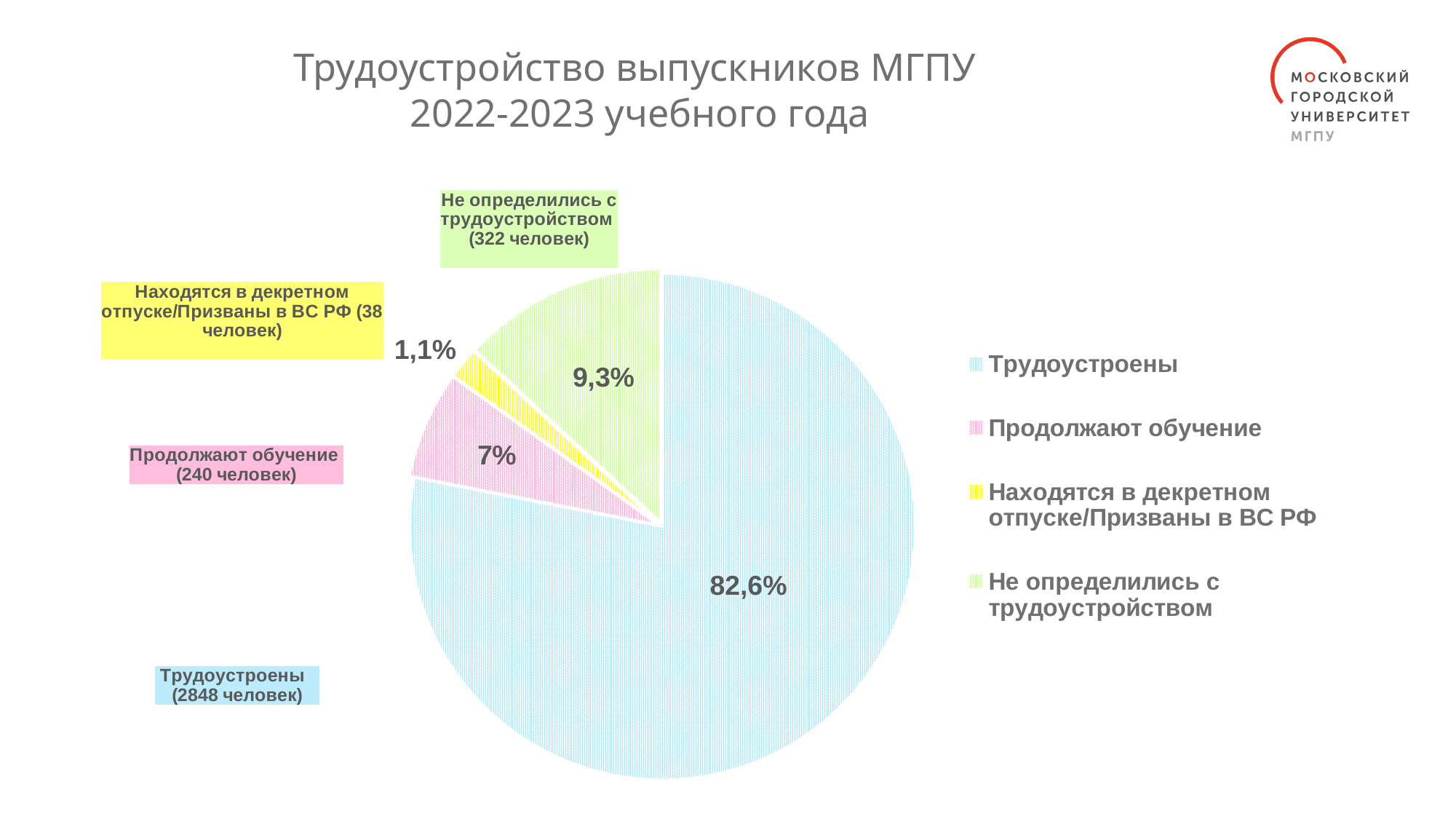
How many people are in the "Трудоустроены" category according to the label on the slide? 2848 человек How many people are in the "Не определились с трудоустройством" category according to the label on the slide? 322 человек What share of the pie does the "Трудоустроены" slice represent? 82,6% What is the difference in percentage points between the "Не определились с трудоустройством" slice and the "Продолжают обучение" slice? 2,3% What percentage is shown for the "Находятся в декретном отпуске/Призваны в ВС РФ" slice? 1,1% Which category has the largest slice of the pie? Трудоустроены What percentage is shown for the "Не определились с трудоустройством" slice? 9,3% How many categories does the pie chart show? 4 What type of chart is shown on the slide? Pie chart Which slice is larger: "Продолжают обучение" or "Не определились с трудоустройством"? Не определились с трудоустройством Which category has the smallest slice of the pie? Находятся в декретном отпуске/Призваны в ВС РФ What percentage is shown for the "Продолжают обучение" slice? 7%